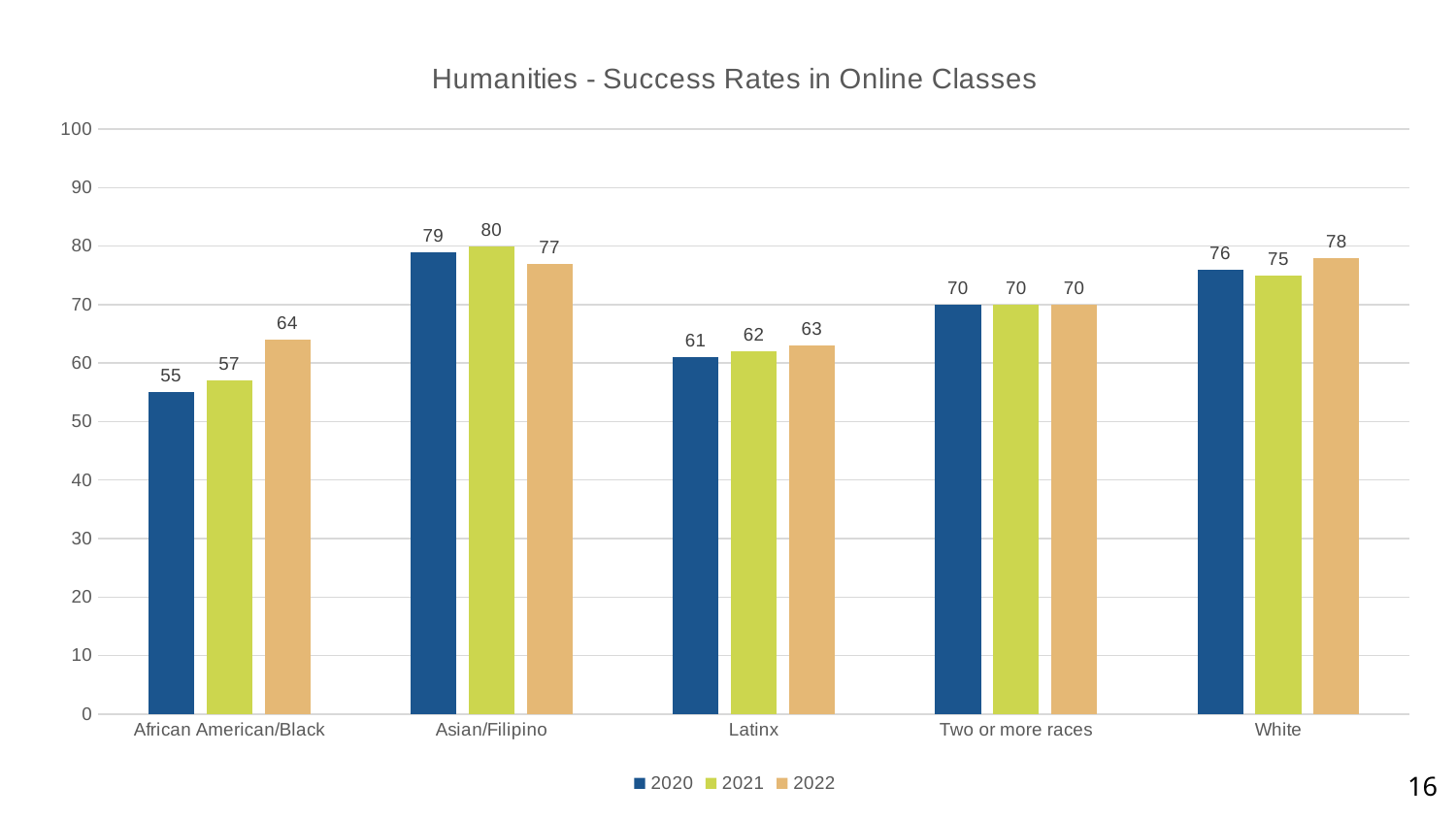
How many series does the legend list? 3 Which category has the highest 2021 success rate? Asian/Filipino How many categories are shown on the x axis? 5 What is the difference between the 2022 and 2020 success rates for African American/Black students? 9 Is the 2020 value for Latinx greater or less than 70? less What is the 2022 success rate for African American/Black students? 64 What is the 2021 success rate for Latinx students? 62 What is the title of the chart? Humanities - Success Rates in Online Classes Which is larger: the 2022 success rate for White students or the 2022 success rate for Asian/Filipino students? White What is the 2020 success rate for Asian/Filipino students? 79 Which category has the lowest 2020 success rate? African American/Black What kind of chart is shown on the slide? bar chart